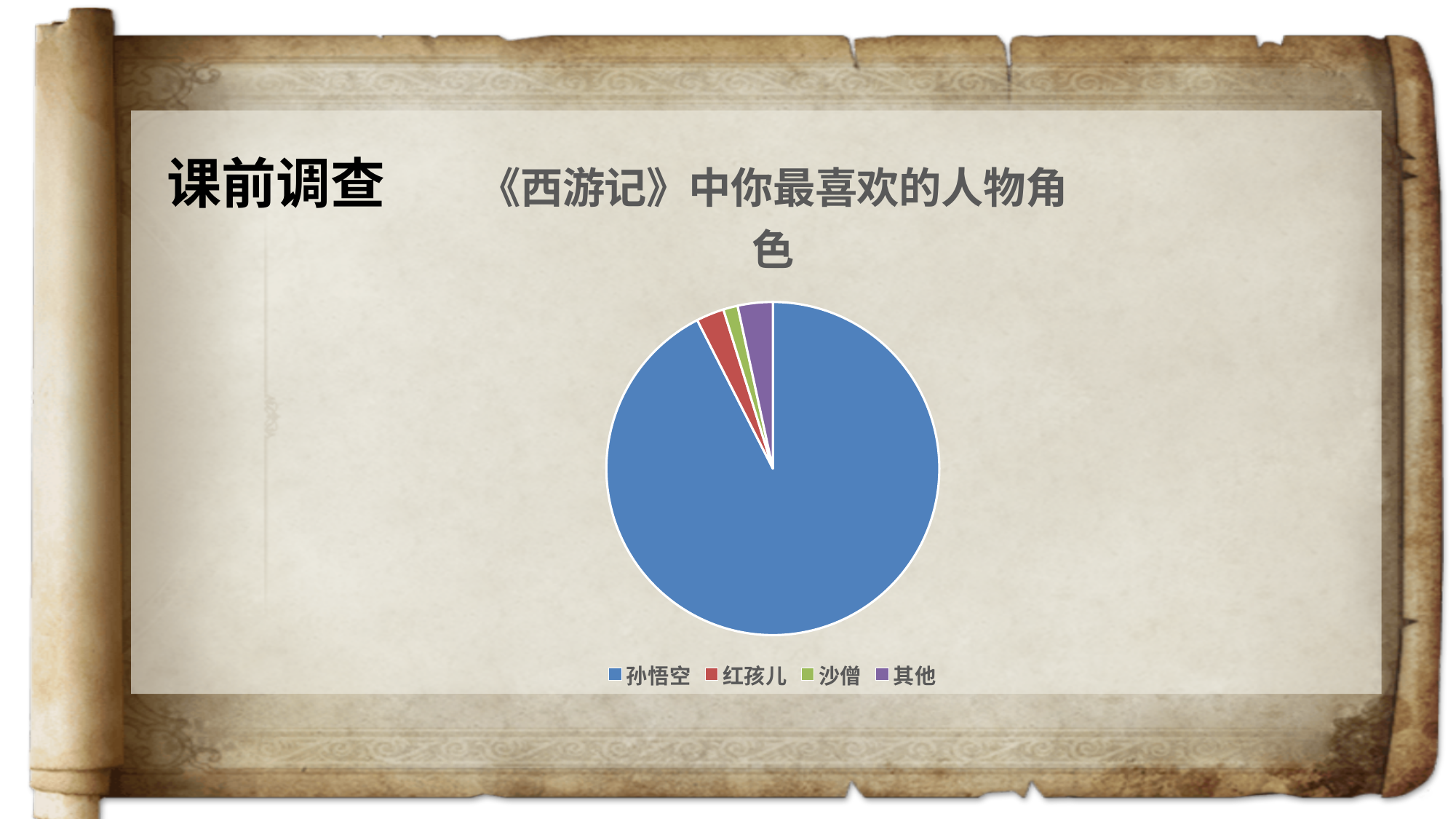
What is the title of the chart? 《西游记》中你最喜欢的人物角色 Which is larger, the slice for 孙悟空 or the slice for 红孩儿? 孙悟空 Which is larger, the slice for 孙悟空 or the slice for 其他? 孙悟空 How many entries does the legend list? 4 Which category has the smallest slice of the pie? 沙僧 What colour is the slice for 孙悟空? blue What kind of chart is shown on the slide? pie chart Which category has the largest slice of the pie? 孙悟空 How many categories does the pie chart show? 4 Which is larger, the slice for 其他 or the slice for 沙僧? 其他